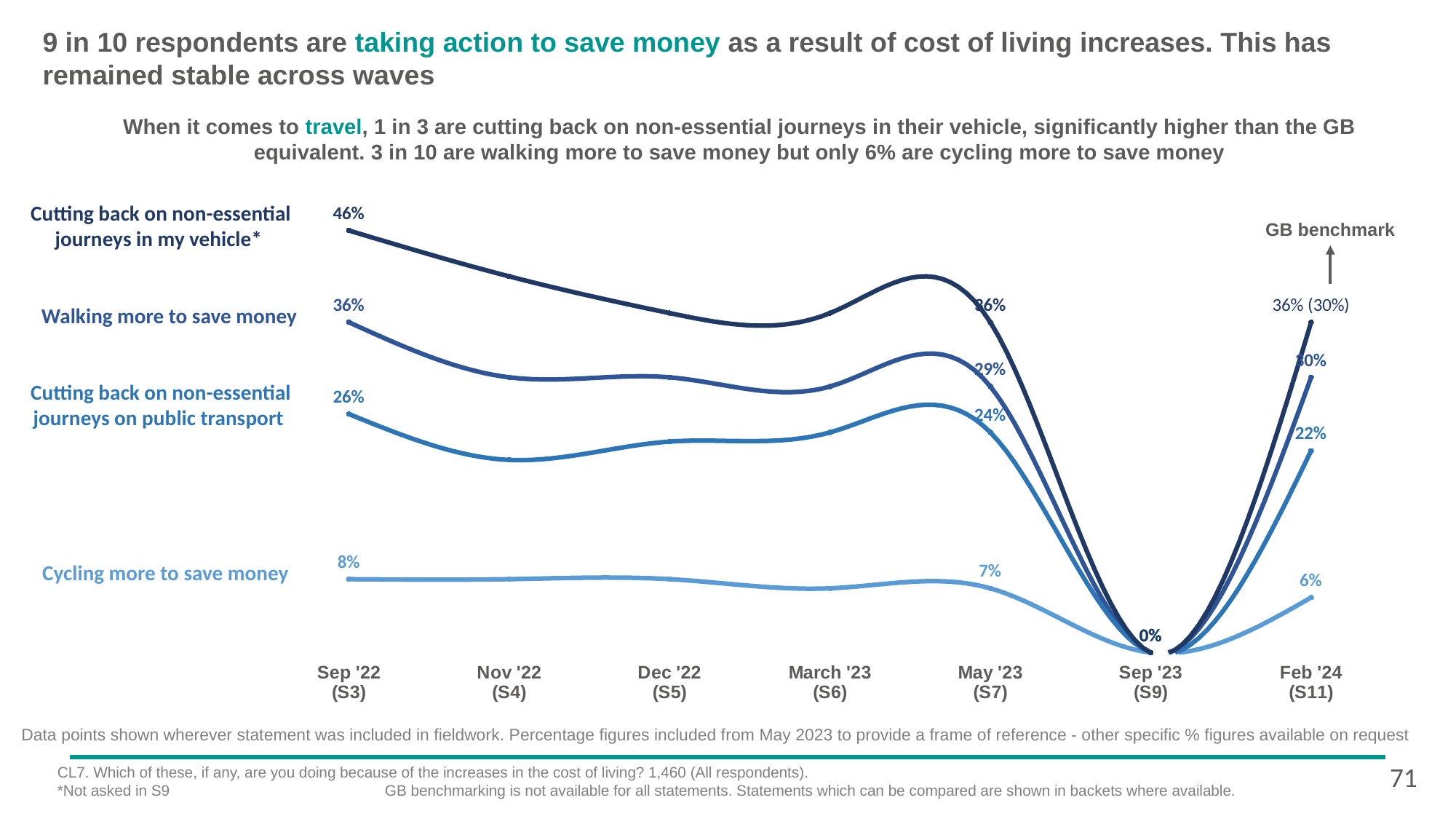
What is the value for 'Cycling more to save money' at Feb '24 (S11)? 6% Which series has the highest value at Sep '22 (S3)? Cutting back on non-essential journeys in my vehicle What is the value for 'Cutting back on non-essential journeys on public transport' at Feb '24 (S11)? 22% Is the value for 'Cutting back on non-essential journeys on public transport' higher at Sep '22 (S3) or at May '23 (S7)? Sep '22 (S3) What is the value for 'Walking more to save money' at Sep '22 (S3)? 36% What is the value for 'Cycling more to save money' at May '23 (S7)? 7% How many time points are shown on the x axis? 7 What kind of chart is shown on the slide? Line chart At Sep '22 (S3), what is the difference between 'Cutting back on non-essential journeys in my vehicle' and 'Walking more to save money'? 10 percentage points Which series has the lowest value at Feb '24 (S11)? Cycling more to save money How many series are plotted on the chart? 4 What is the value for 'Cutting back on non-essential journeys in my vehicle' at Sep '22 (S3)? 46%